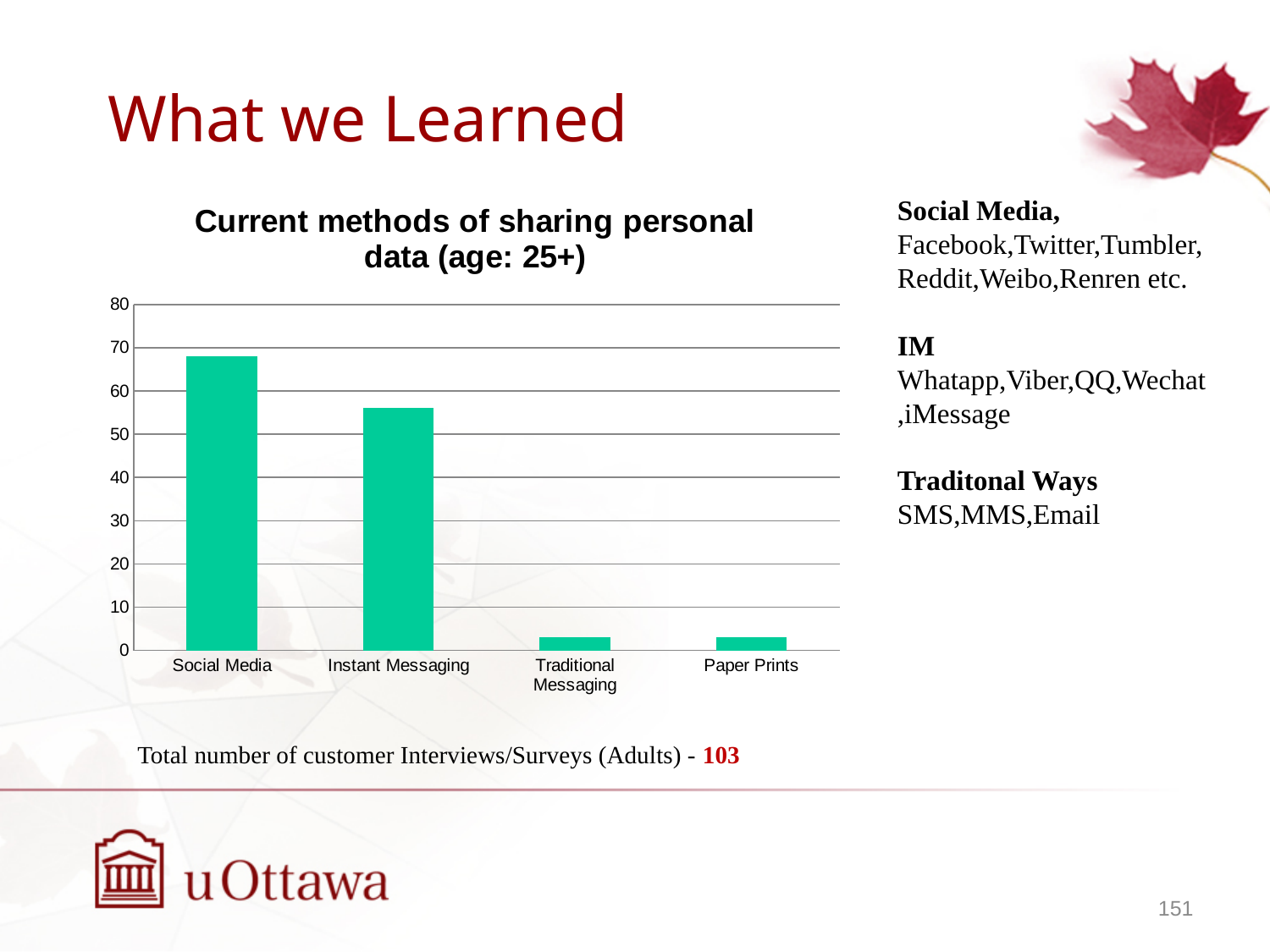
Is the value for Traditional Messaging greater or less than 10? less Is the value for Social Media greater or less than 70? less How many categories are shown on the x axis of the chart? 4 Which is larger, the value for Instant Messaging or the value for Paper Prints? Instant Messaging What kind of chart is shown on the slide? bar chart Is the value for Paper Prints greater or less than 10? less Which is larger, the value for Social Media or the value for Instant Messaging? Social Media Which category has the highest value in the chart? Social Media What is the highest value shown on the y axis of the chart? 80 What is the title of the chart? Current methods of sharing personal data (age: 25+)